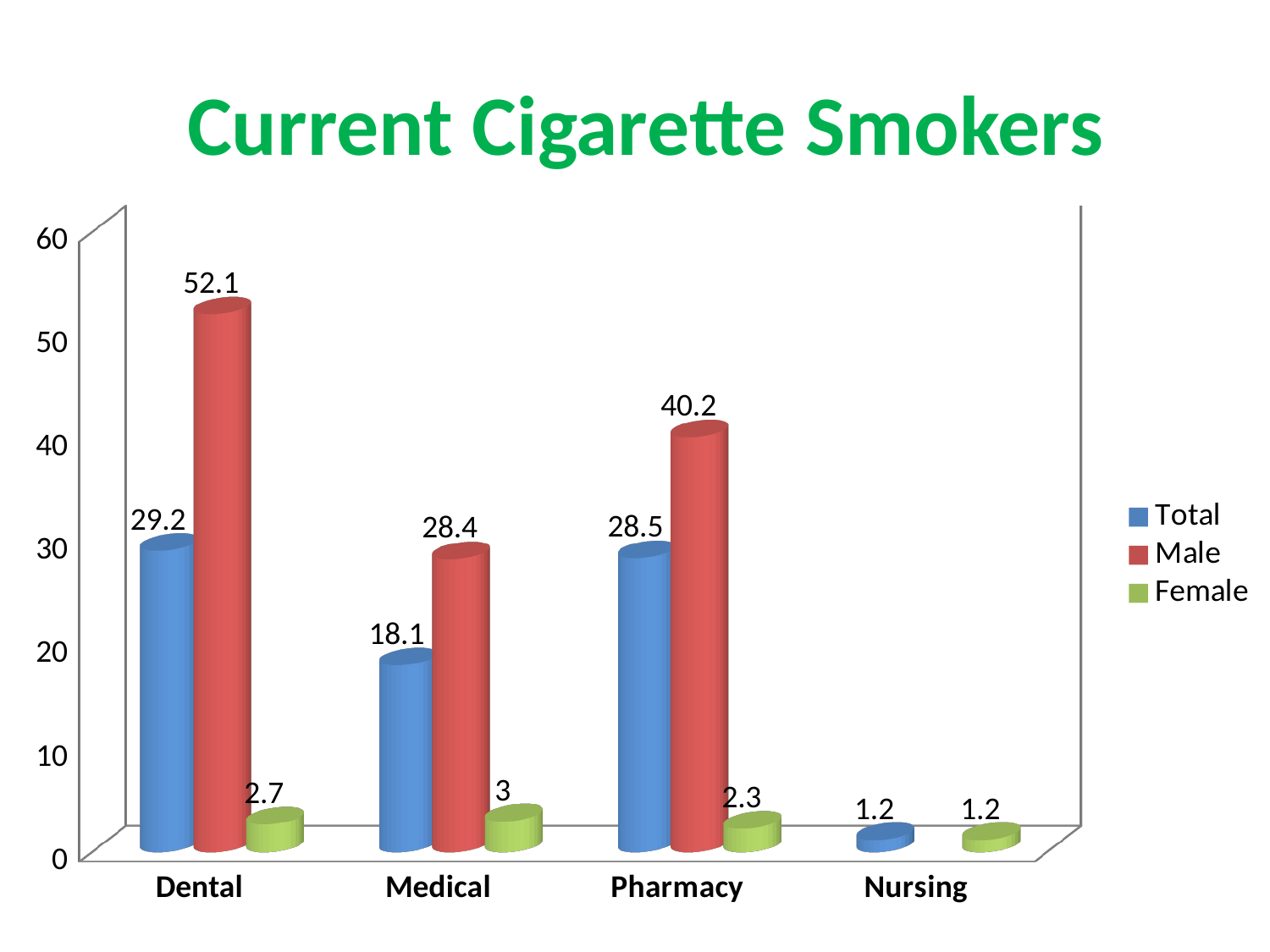
What is the Total value for Medical? 18.1 Which is larger, the Total value for Dental or the Total value for Pharmacy? Dental How many series does the legend list? 3 What is the difference between the Male and Total values for Pharmacy? 11.7 What kind of chart is shown on the slide? Bar chart What is the title of the chart? Current Cigarette Smokers What is the Total value for Nursing? 1.2 Which category has the highest Male value? Dental What is the Male value for Dental? 52.1 How many categories are shown on the x axis? 4 Which category has the lowest Total value? Nursing What is the Female value for Pharmacy? 2.3